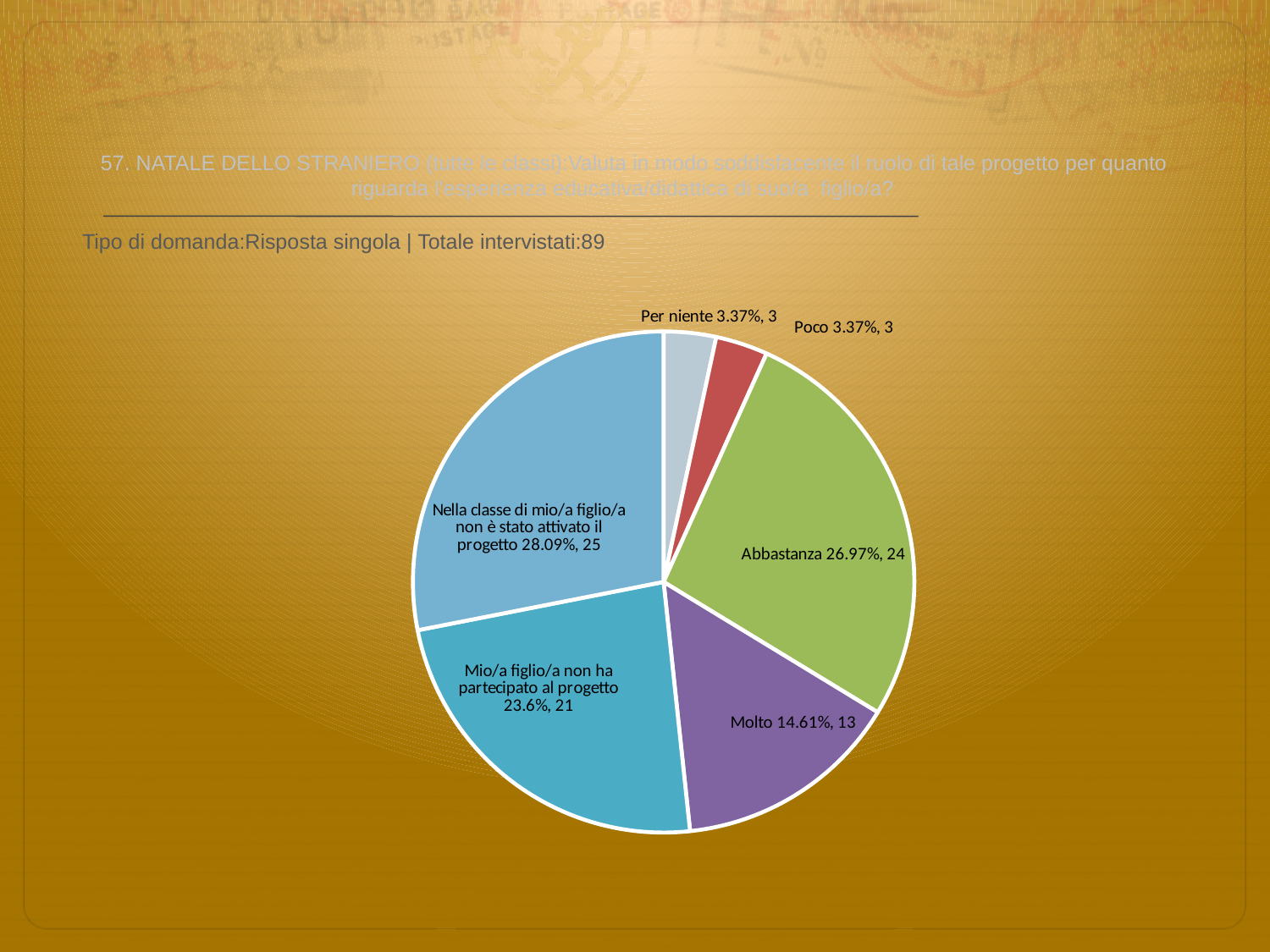
What percentage is shown for "Mio/a figlio/a non ha partecipato al progetto"? 23.6% How many slices does the pie chart have? 6 What is the difference in respondent count between "Nella classe di mio/a figlio/a non è stato attivato il progetto" and "Mio/a figlio/a non ha partecipato al progetto"? 4 How many respondents answered "Per niente"? 3 What percentage is shown for "Abbastanza"? 26.97% What kind of chart is shown on the slide? Pie chart Which category has the largest share of the pie? Nella classe di mio/a figlio/a non è stato attivato il progetto How many respondents answered "Molto"? 13 What is the total number of respondents stated on the slide (Totale intervistati)? 89 Which is larger, the count for "Abbastanza" or the count for "Molto"? Abbastanza What is the share of the pie for "Nella classe di mio/a figlio/a non è stato attivato il progetto"? 28.09% What is the difference in respondent count between "Abbastanza" and "Molto"? 11